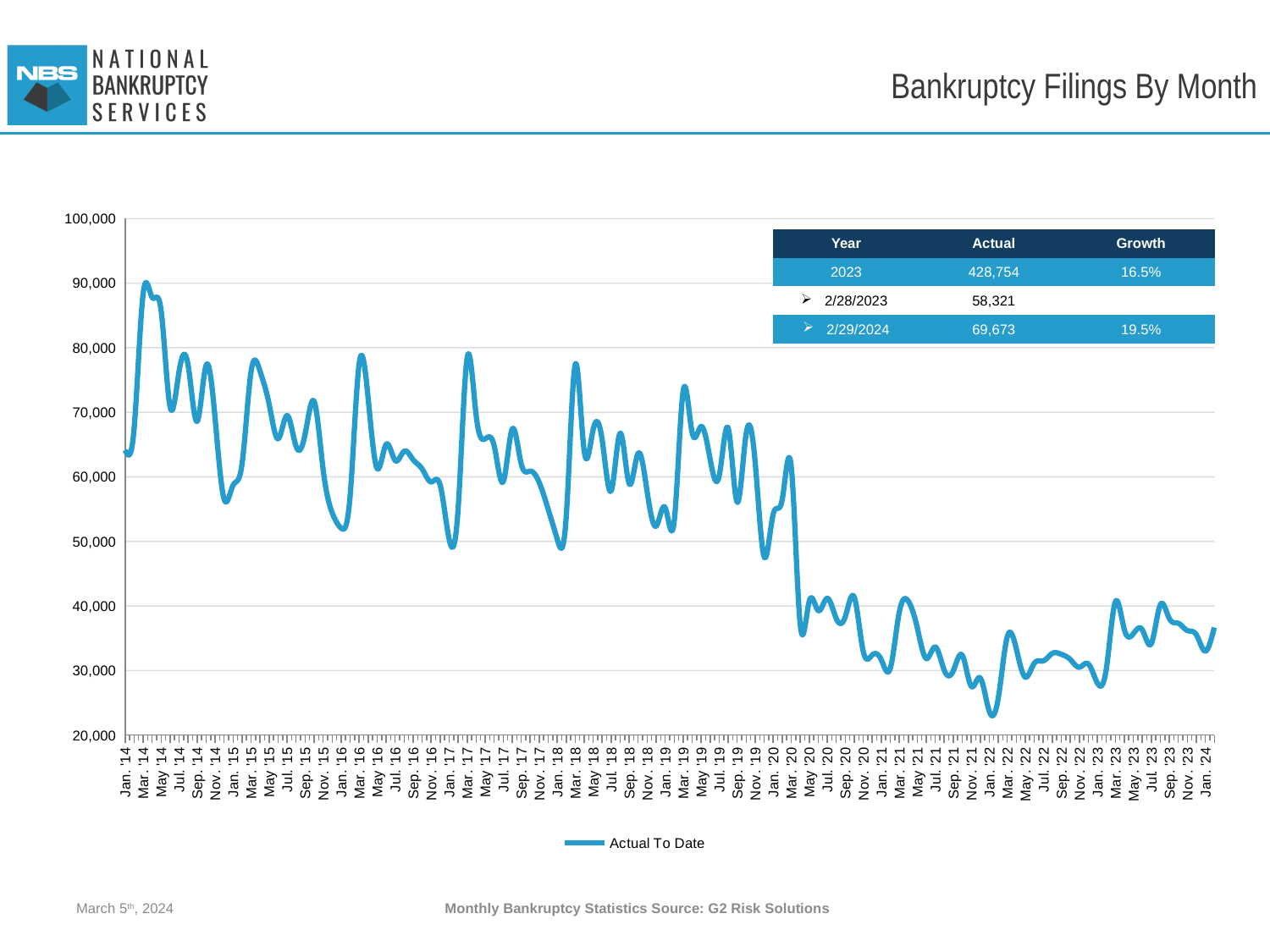
According to the table on the chart, what is the Actual value for 2023? 428,754 Overall, do the monthly bankruptcy filings rise or fall from 2014 to 2024? fall What kind of chart is shown on the slide? line chart What is the title of the chart on the slide? Bankruptcy Filings By Month Is the value for Jan. '24 greater or less than 40,000? less According to the table on the chart, what is the difference between the Actual values for 2/29/2024 and 2/28/2023? 11,352 Is the value for Jan. '22 greater or less than 30,000? less What is the name of the series shown in the chart legend? Actual To Date Is the value for Jan. '14 greater or less than 60,000? greater In which year does the line reach its highest point? 2014 How many series does the chart legend list? 1